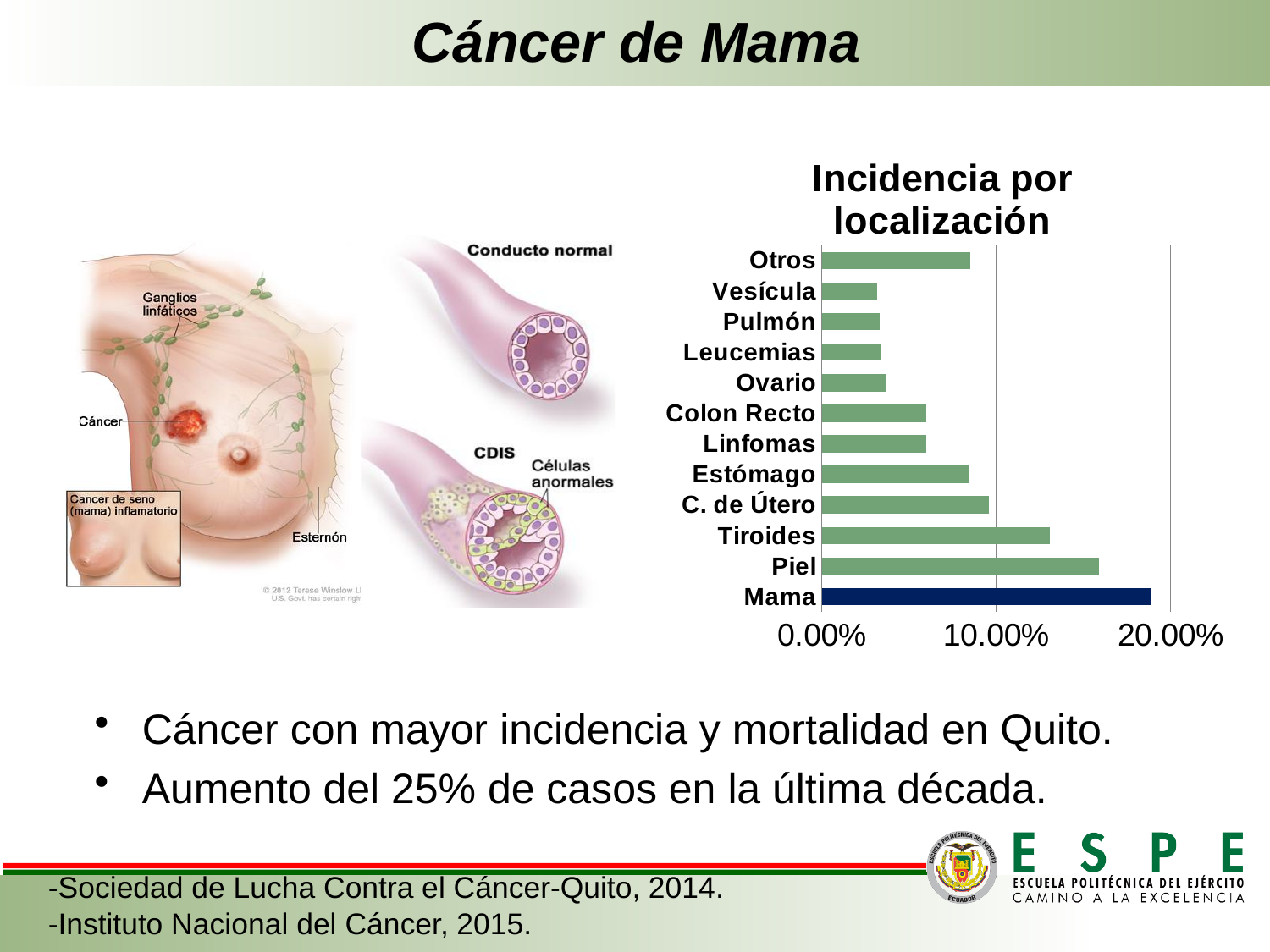
Is the value for Vesícula greater or less than 10.00%? less Is the value for Otros greater or less than 10.00%? less Which has a higher incidence, Colon Recto or Ovario? Colon Recto Which has a higher incidence, Tiroides or Otros? Tiroides What kind of chart is shown on the slide? bar chart Which has a higher incidence, Mama or Piel? Mama Which category's bar is drawn in a different colour (dark blue) from the others? Mama Is the value for Piel greater or less than 10.00%? greater Which category has the highest incidence in the chart? Mama How many categories are plotted in the chart? 12 What is the title of the chart? Incidencia por localización